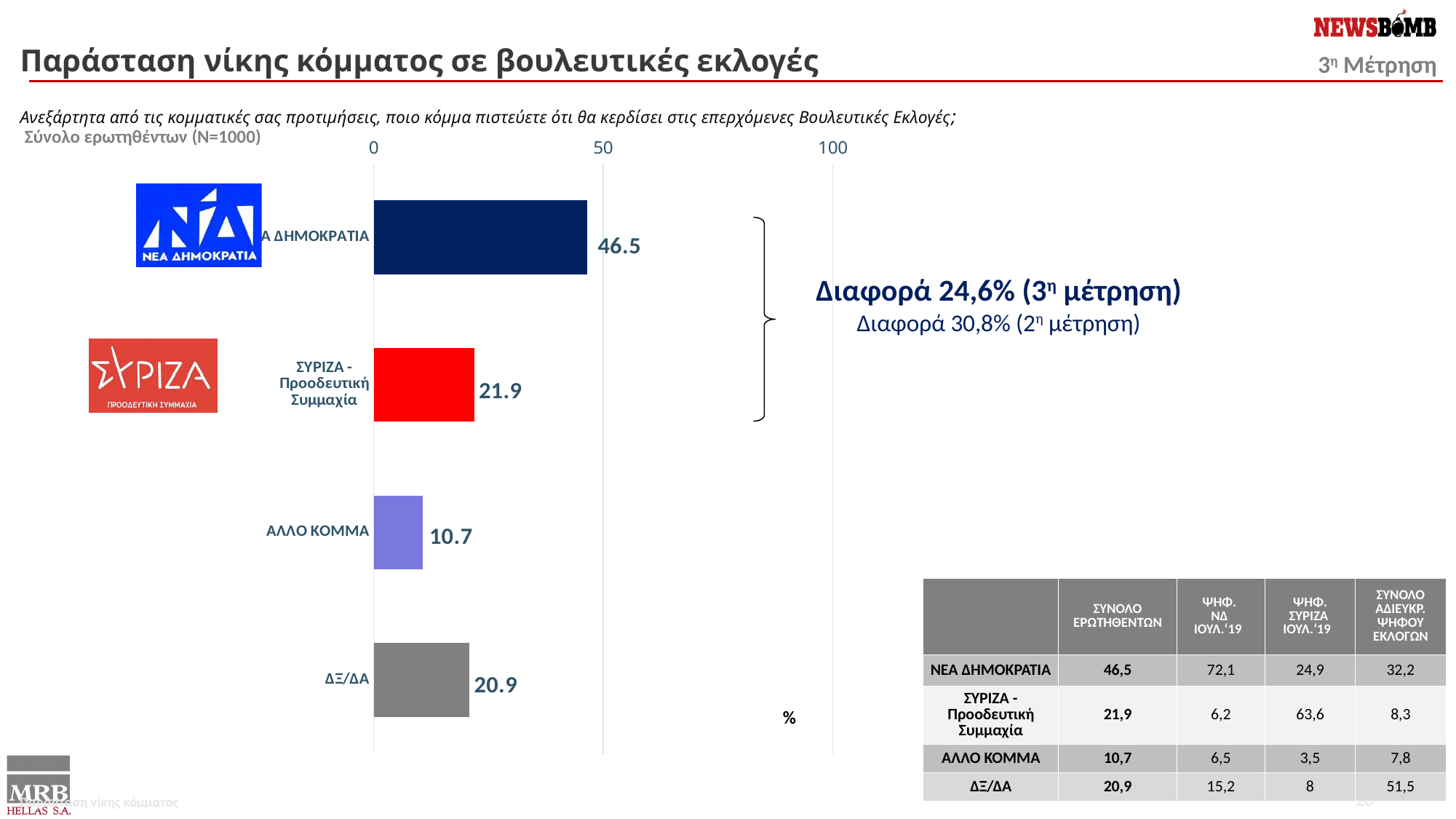
How many categories are shown in the bar chart? 4 Which is larger in the bar chart, the value for ΣΥΡΙΖΑ - Προοδευτική Συμμαχία or the value for ΑΛΛΟ ΚΟΜΜΑ? ΣΥΡΙΖΑ - Προοδευτική Συμμαχία Which category has the highest value in the bar chart? ΝΕΑ ΔΗΜΟΚΡΑΤΙΑ What value is shown for ΔΞ/ΔΑ in the bar chart? 20.9 What colour is the bar for ΣΥΡΙΖΑ - Προοδευτική Συμμαχία in the bar chart? red What value is shown for ΣΥΡΙΖΑ - Προοδευτική Συμμαχία in the bar chart? 21.9 What value is shown for ΑΛΛΟ ΚΟΜΜΑ in the bar chart? 10.7 What is the difference between the values for ΝΕΑ ΔΗΜΟΚΡΑΤΙΑ and ΣΥΡΙΖΑ - Προοδευτική Συμμαχία in the bar chart? 24.6 Which category has the lowest value in the bar chart? ΑΛΛΟ ΚΟΜΜΑ What value is shown for ΝΕΑ ΔΗΜΟΚΡΑΤΙΑ in the bar chart? 46.5 Is the value for ΝΕΑ ΔΗΜΟΚΡΑΤΙΑ in the bar chart greater or less than 50? less What kind of chart is shown on the slide? bar chart